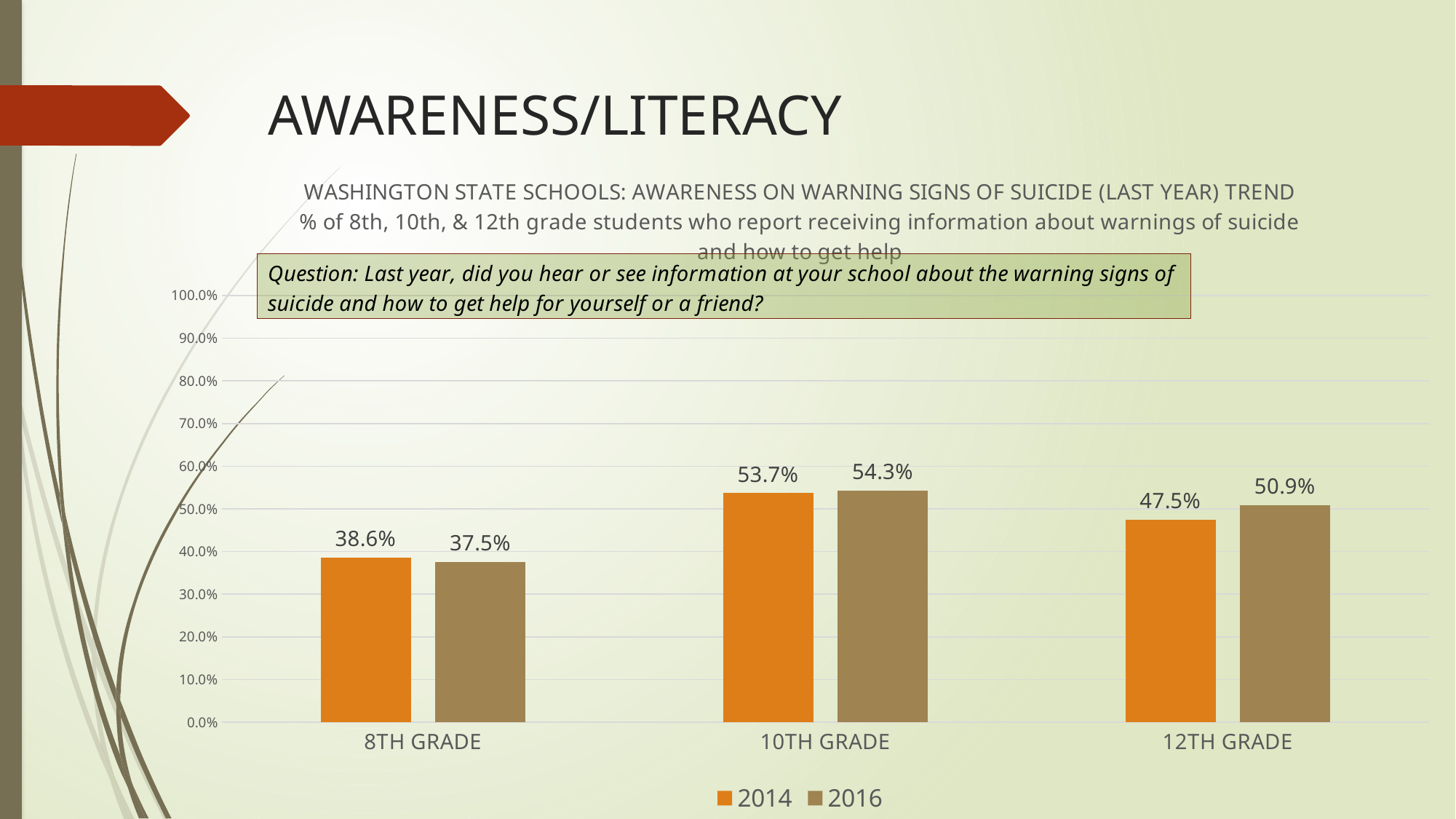
Which grade has the highest value in 2014? 10th grade How many grade categories are shown on the x axis? 3 What is the difference between the 2016 and 2014 values for 12th grade? 3.4% Which years are listed in the legend? 2014 and 2016 What kind of chart is shown on the slide? Bar chart What is the value for 8th grade in 2014? 38.6% What is the value for 12th grade in 2016? 50.9% Which is larger for 8th grade, the 2014 value or the 2016 value? 2014 Which grade has the lowest value in 2016? 8th grade How many series does the legend list? 2 Is the value for 10th grade in 2014 greater or less than 50.0%? greater What is the value for 10th grade in 2016? 54.3%